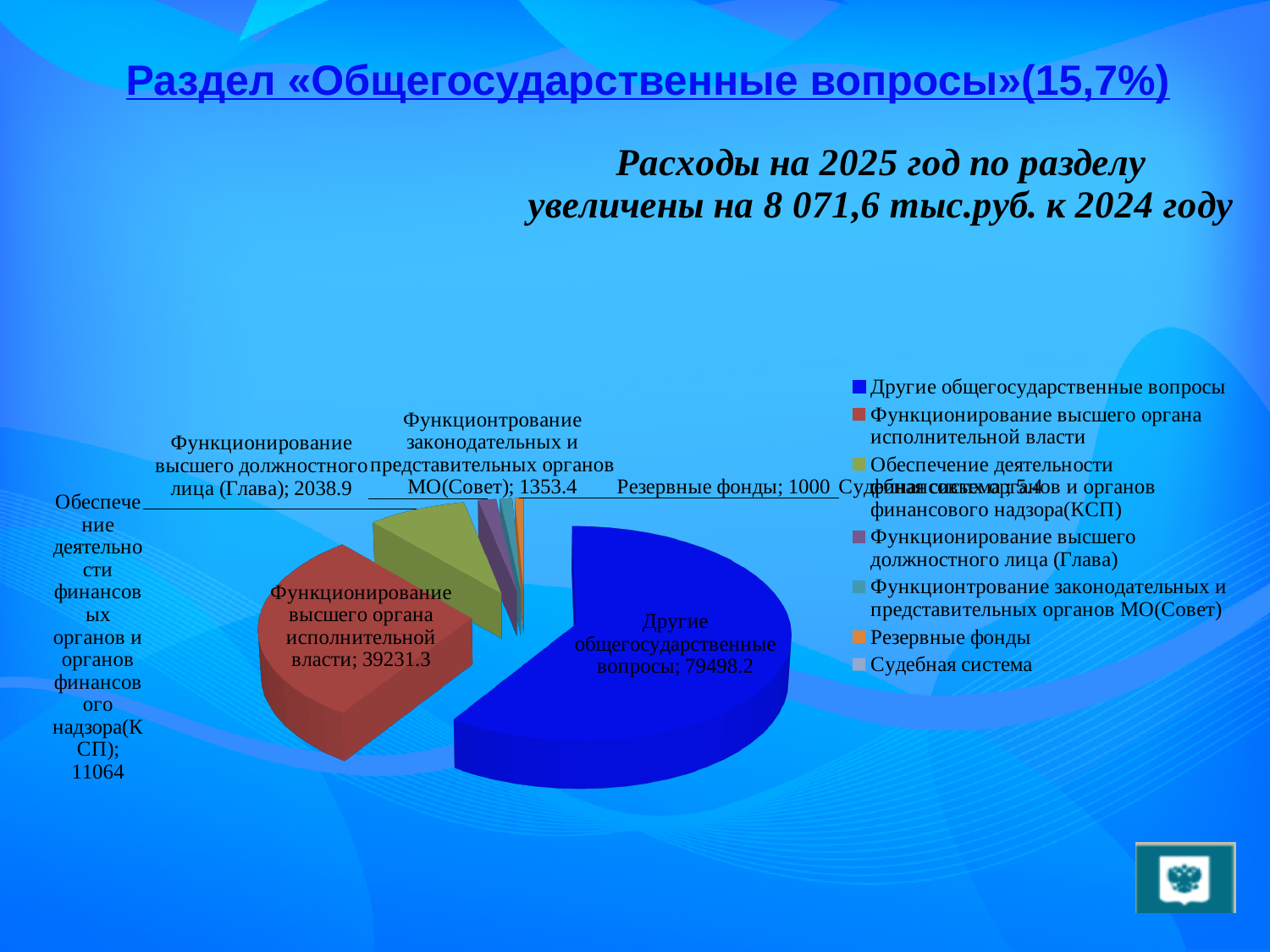
What is the value for «Функционирование высшего должностного лица (Глава)»? 2038.9 What is the value for «Обеспечение деятельности финансовых органов и органов финансового надзора(КСП)»? 11064 How many entries does the legend list? 7 What is the difference between «Другие общегосударственные вопросы» and «Функционирование высшего органа исполнительной власти»? 40266.9 What is the value for «Функционирование высшего органа исполнительной власти»? 39231.3 What colour is the slice for «Другие общегосударственные вопросы»? Blue Which is larger: «Обеспечение деятельности финансовых органов и органов финансового надзора(КСП)» or «Резервные фонды»? Обеспечение деятельности финансовых органов и органов финансового надзора(КСП) What kind of chart is shown on the slide? Pie chart What is the value for «Другие общегосударственные вопросы»? 79498.2 What is the difference between «Функционирование высшего должностного лица (Глава)» and «Функционтрование законодательных и представительных органов МО(Совет)»? 685.5 What is the value for «Резервные фонды»? 1000 Which category has the largest slice of the pie? Другие общегосударственные вопросы